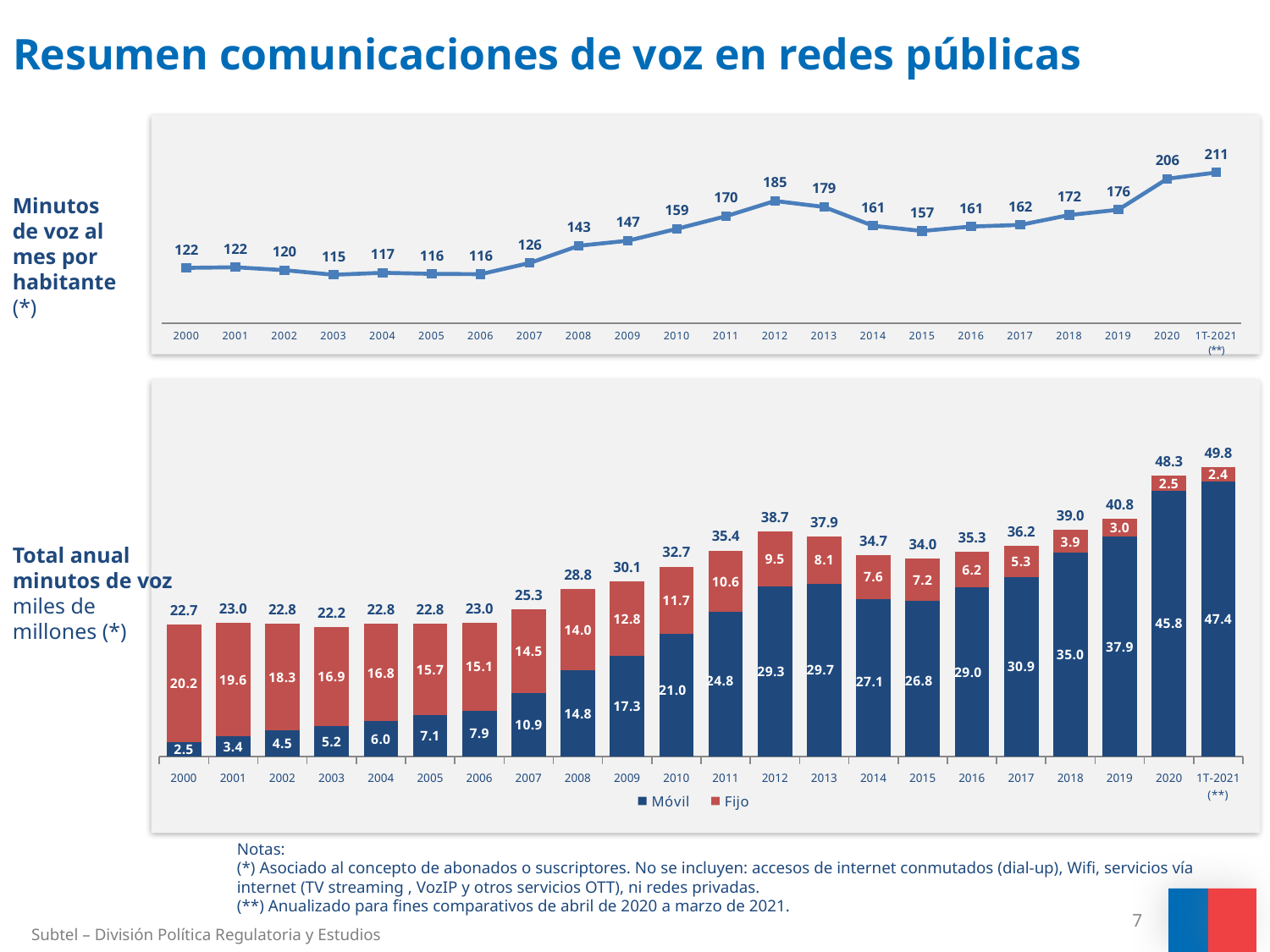
How many series does the legend of the bottom chart (Total anual minutos de voz) list? 2 In the bottom chart (Total anual minutos de voz), what is the Móvil value for 2010? 21.0 In the top chart (Minutos de voz al mes por habitante), what is the value for 2012? 185 In the bottom chart (Total anual minutos de voz), is the Móvil value for 2008 larger or smaller than the Fijo value for 2008? Larger What kind of chart is the top chart (Minutos de voz al mes por habitante)? Line chart In the top chart (Minutos de voz al mes por habitante), what is the difference between the values for 2020 and 2019? 30 What kind of chart is the bottom chart (Total anual minutos de voz)? Stacked bar chart In the top chart (Minutos de voz al mes por habitante), which year has the lowest value? 2003 In the bottom chart (Total anual minutos de voz), what is the Fijo value for 2000? 20.2 In the bottom chart (Total anual minutos de voz), which year has the highest Fijo value? 2000 In the top chart (Minutos de voz al mes por habitante), which point has the highest value? 1T-2021 In the bottom chart (Total anual minutos de voz), what is the total of the stacked bar for 2012? 38.7